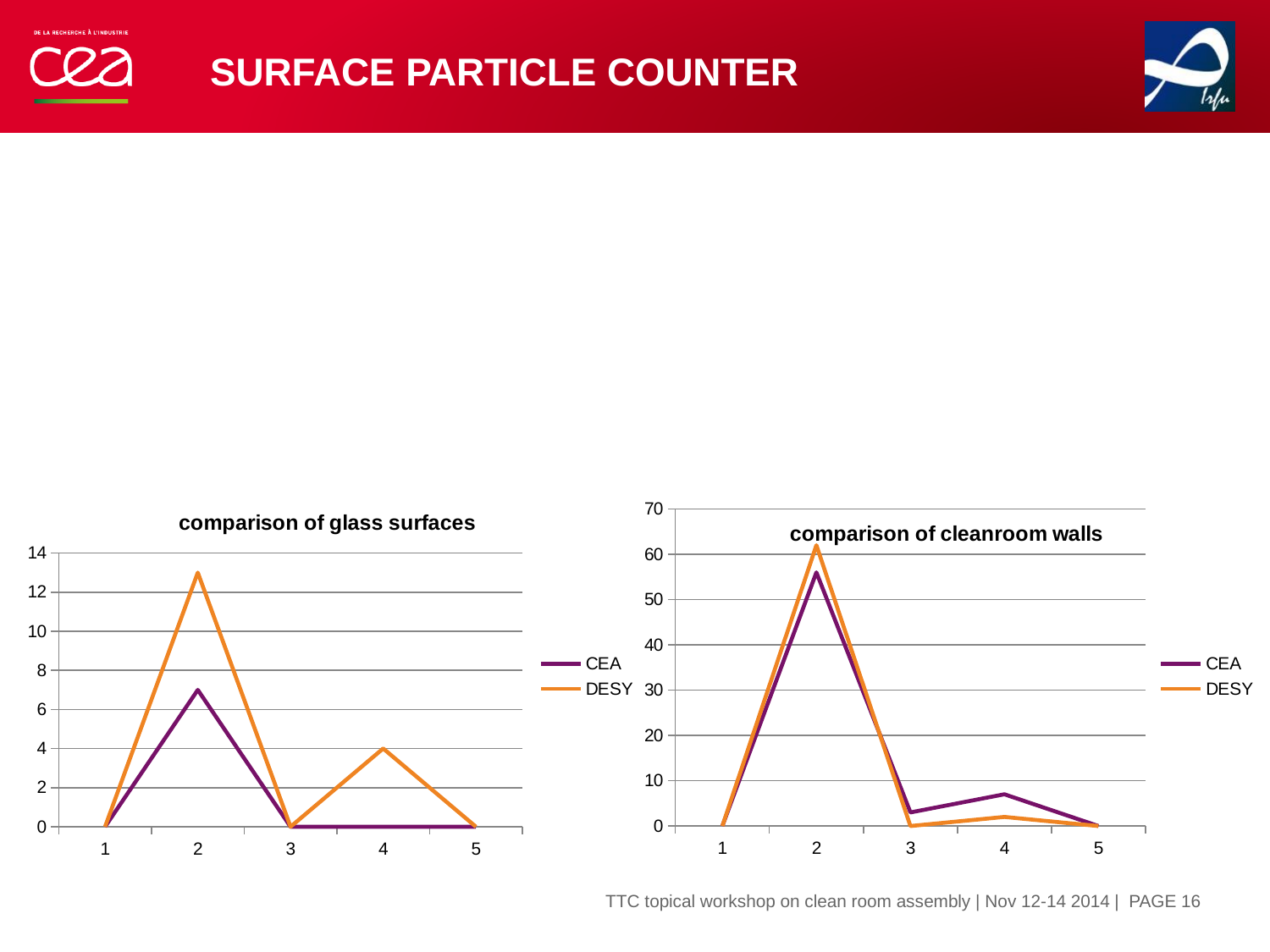
In the 'comparison of glass surfaces' chart, which series has the larger value at category 4, CEA or DESY? DESY In the 'comparison of glass surfaces' chart, is the CEA value at category 2 greater or less than 8? less In the 'comparison of cleanroom walls' chart, which series has the larger value at category 4, CEA or DESY? CEA In the 'comparison of glass surfaces' chart, what is the CEA value at category 5? 0 In the 'comparison of cleanroom walls' chart, is the CEA value at category 2 greater or less than 60? less In the 'comparison of glass surfaces' chart, at which x-axis category does the DESY series reach its highest value? 2 Which colour is used for the DESY series in both charts? orange In the 'comparison of glass surfaces' chart, is the DESY value at category 2 greater or less than 12? greater What type of chart is the 'comparison of glass surfaces' chart? line chart How many series does the legend of the 'comparison of cleanroom walls' chart list? 2 How many points are plotted along the x axis of the 'comparison of glass surfaces' chart for each series? 5